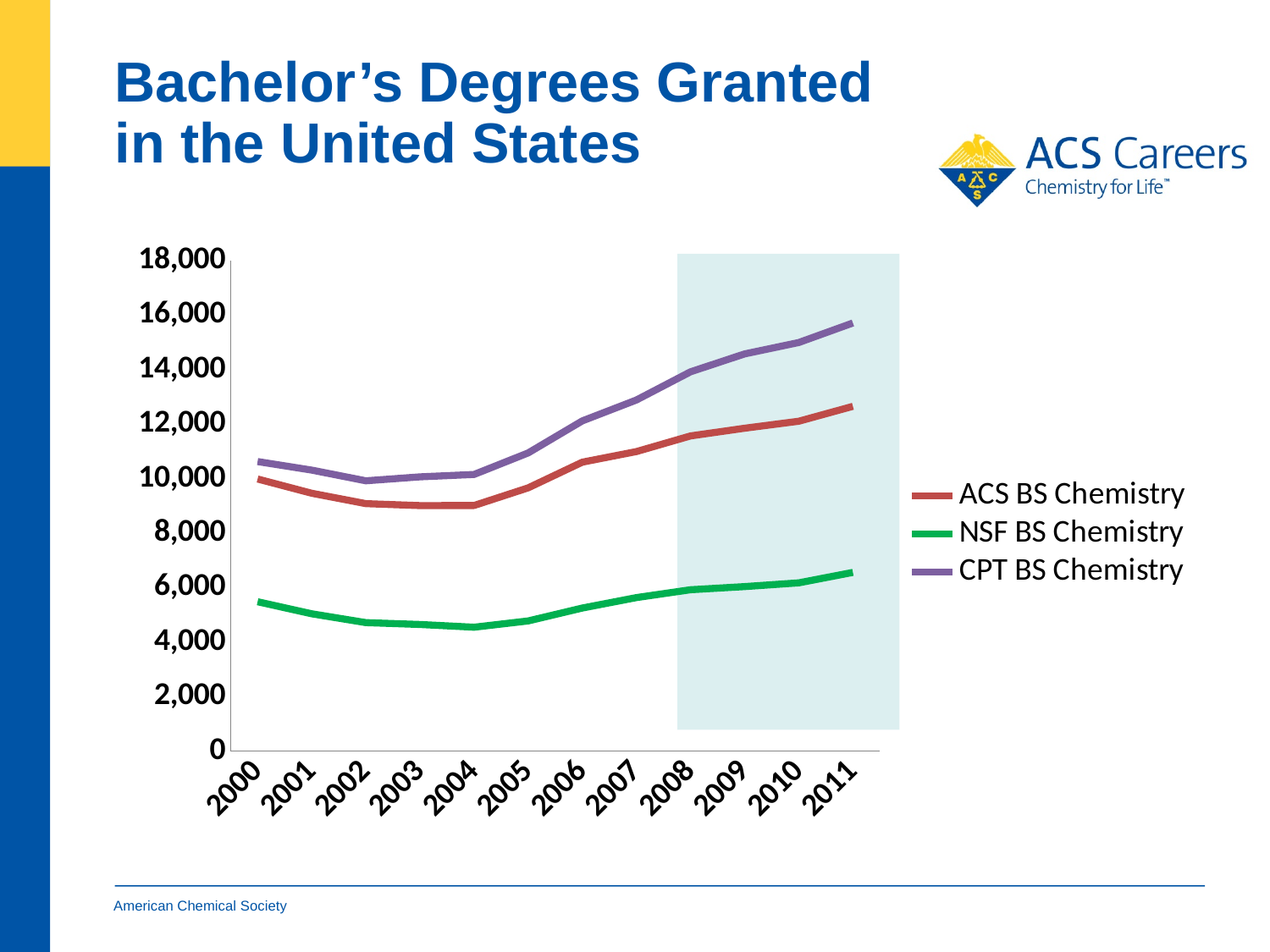
Is the value for ACS BS Chemistry in 2011 greater or less than 10,000? greater Which series has the highest value in 2011? CPT BS Chemistry Is the value for CPT BS Chemistry in 2011 greater or less than 14,000? greater Is the value for ACS BS Chemistry in 2000 greater or less than 8,000? greater How many years are shown along the x axis? 12 What kind of chart is shown on the slide? line chart What colour is the NSF BS Chemistry line? green In 2011, which is larger: ACS BS Chemistry or NSF BS Chemistry? ACS BS Chemistry How many series does the legend list? 3 Which series has the lowest values across all years shown? NSF BS Chemistry Does the CPT BS Chemistry line rise or fall from 2004 to 2011? rise